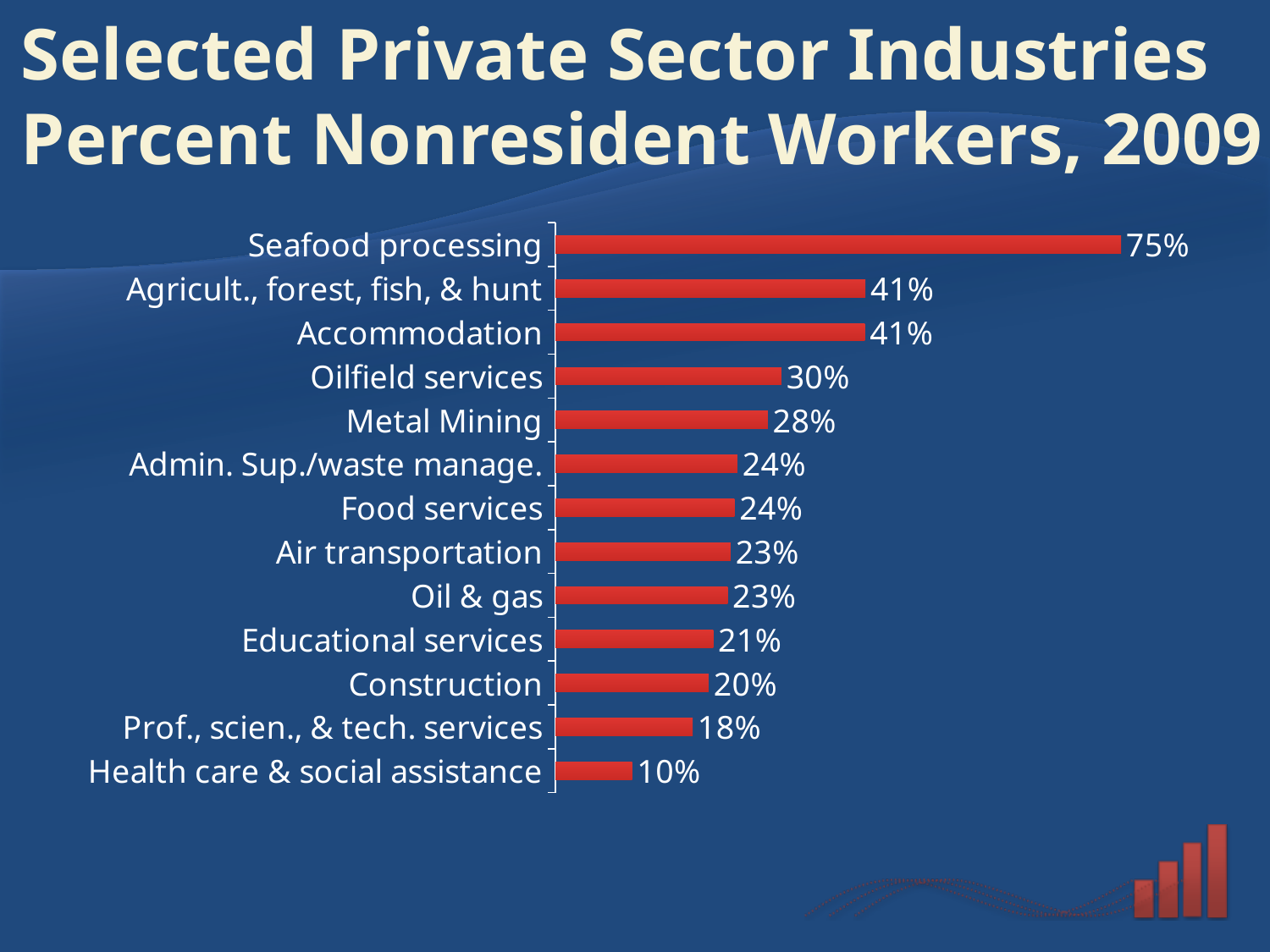
Which industry has the lowest percent of nonresident workers? Health care & social assistance What is the difference in percent nonresident workers between Seafood processing and Accommodation? 34% What is the percent of nonresident workers for Construction? 20% What is the percent of nonresident workers for Health care & social assistance? 10% Which industry has the highest percent of nonresident workers? Seafood processing What is the percent of nonresident workers for Seafood processing? 75% How many industries are shown in the chart? 13 What colour are the bars in the chart? Red What kind of chart is shown on the slide? Bar chart What is the percent of nonresident workers for Metal Mining? 28% What is the difference in percent nonresident workers between Oilfield services and Construction? 10% Which has a higher percent of nonresident workers, Metal Mining or Educational services? Metal Mining